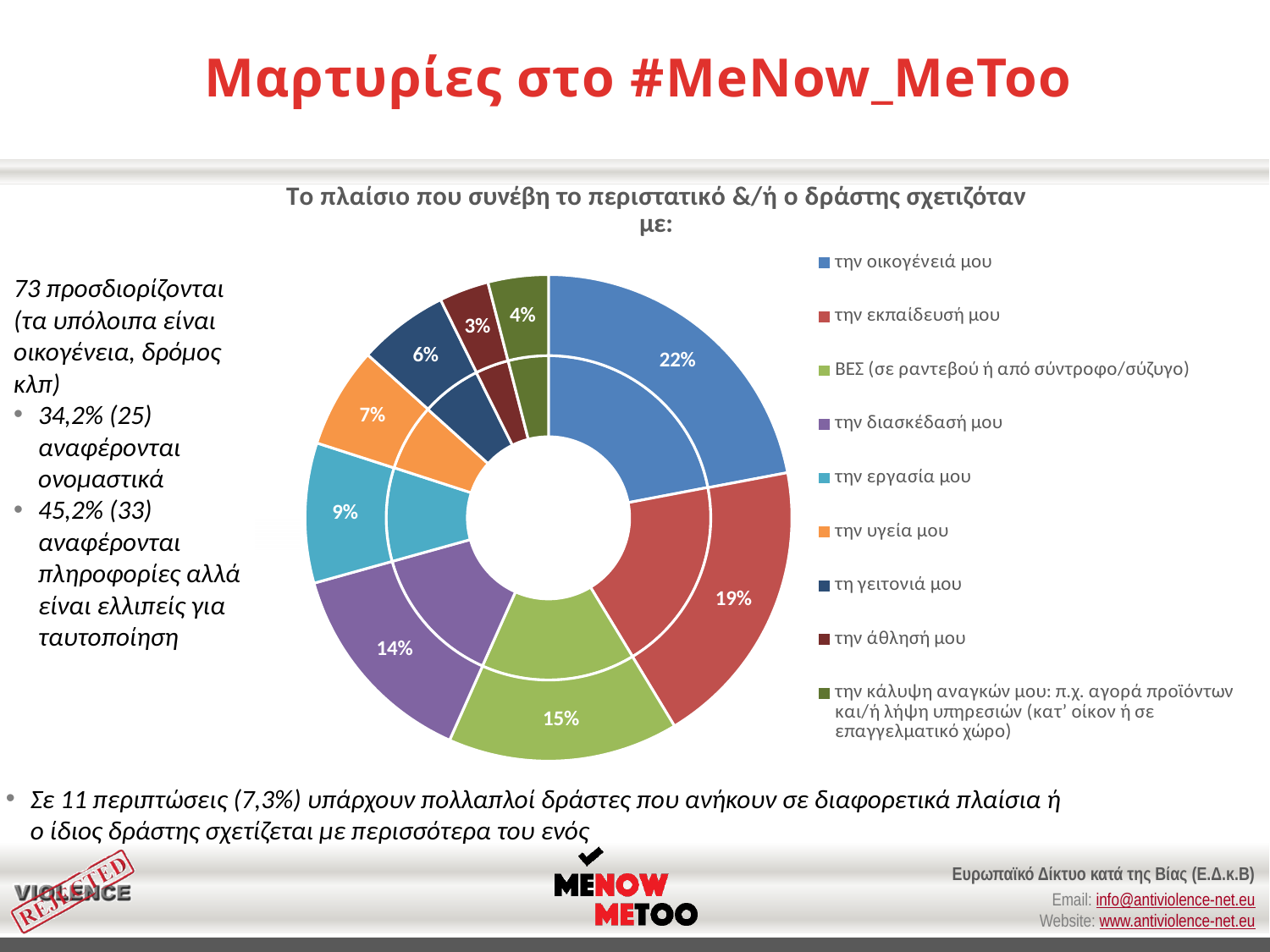
What colour represents 'την υγεία μου' in the chart? Orange What is the difference in percentage points between 'την οικογένειά μου' and 'την εκπαίδευσή μου'? 3 What share does 'ΒΕΣ (σε ραντεβού ή από σύντροφο/σύζυγο)' have in the chart? 15% What is the combined share of 'τη γειτονιά μου' and 'την άθλησή μου'? 9% Which category has the largest share in the chart? την οικογένειά μου What kind of chart is shown on the slide? Pie (doughnut) chart How many categories does the chart's legend list? 9 What percentage is shown for 'την εκπαίδευσή μου'? 19% What percentage is shown for 'την εργασία μου'? 9% What percentage of the pie chart corresponds to 'την οικογένειά μου'? 22% Which category has the smallest share in the chart? την άθλησή μου Which is larger: the share for 'την διασκέδασή μου' or the share for 'την υγεία μου'? την διασκέδασή μου